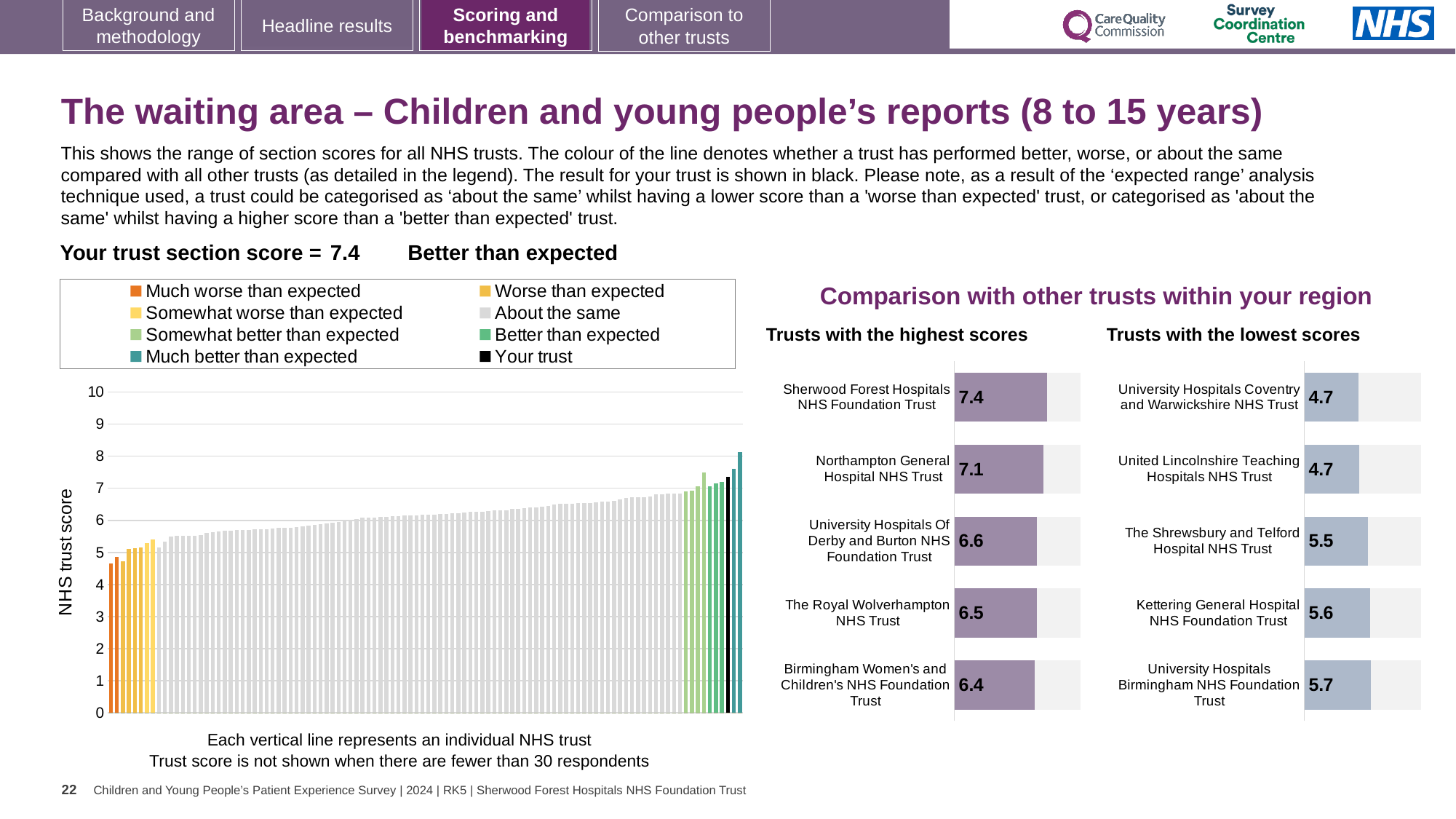
In the 'Trusts with the lowest scores' chart, how many trusts are shown? 5 In the large chart on the left showing all NHS trusts, is the value for the black bar (your trust) greater or less than 7? greater In the 'Trusts with the lowest scores' chart, what is the score for The Shrewsbury and Telford Hospital NHS Trust? 5.5 In the 'Trusts with the highest scores' chart, what is the score for Sherwood Forest Hospitals NHS Foundation Trust? 7.4 In the 'Trusts with the lowest scores' chart, which trust has the highest score? University Hospitals Birmingham NHS Foundation Trust In the 'Trusts with the highest scores' chart, what is the difference between the scores of Sherwood Forest Hospitals NHS Foundation Trust and Northampton General Hospital NHS Trust? 0.3 In the 'Trusts with the highest scores' chart, which trust has the lowest score? Birmingham Women's and Children's NHS Foundation Trust In the 'Trusts with the highest scores' chart, what is the score for The Royal Wolverhampton NHS Trust? 6.5 What kind of chart is the large chart on the left showing all NHS trusts? bar chart How many entries does the legend above the large chart on the left list? 8 In the 'Trusts with the lowest scores' chart, which has the larger score: Kettering General Hospital NHS Foundation Trust or The Shrewsbury and Telford Hospital NHS Trust? Kettering General Hospital NHS Foundation Trust In the large chart on the left showing all NHS trusts, do the bar values rise or fall from left to right? rise